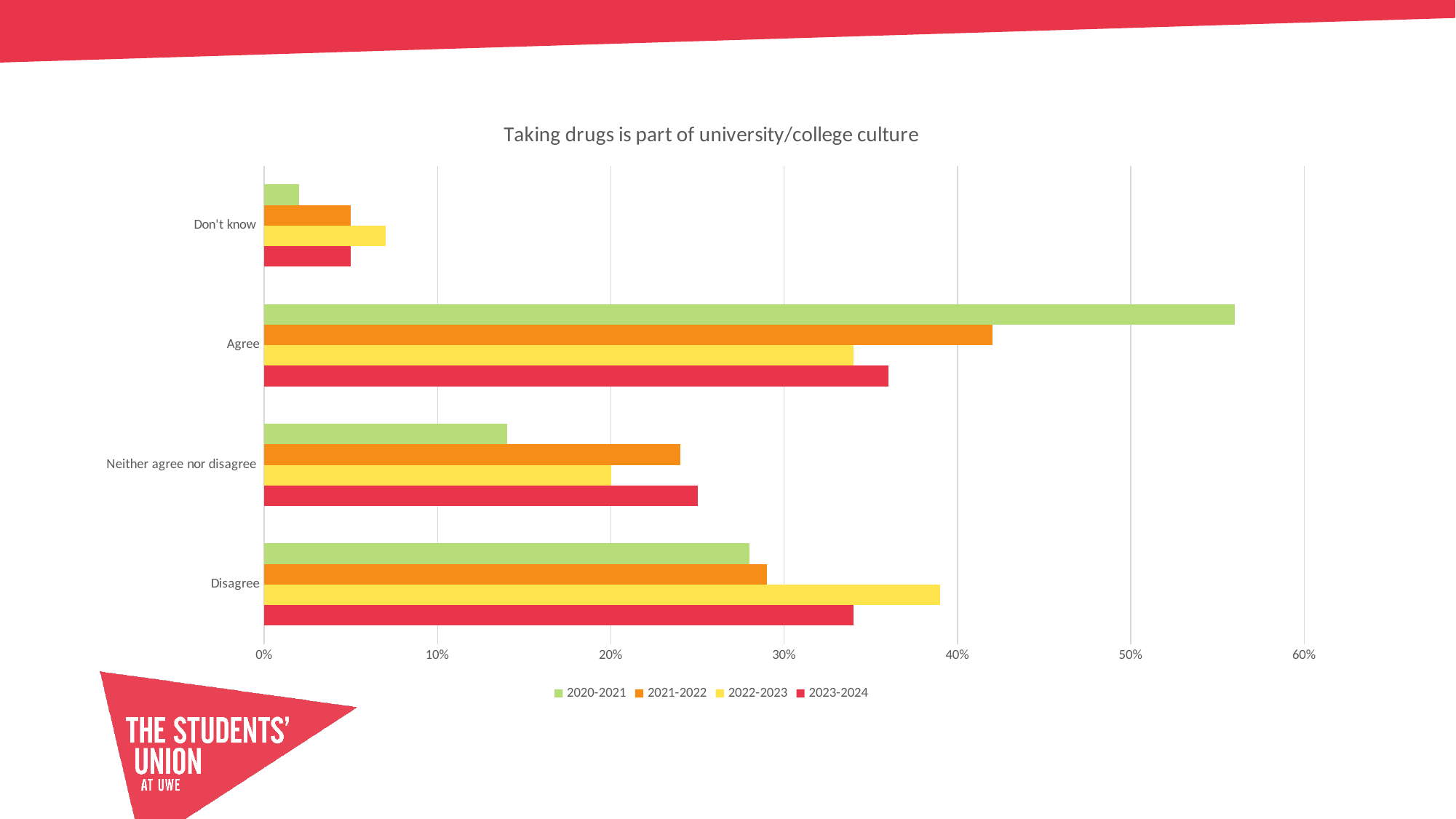
What kind of chart is shown on the slide? bar chart What is the title of the chart? Taking drugs is part of university/college culture Which series is shown in green in the legend? 2020-2021 Is the value for Disagree in 2022-2023 greater or less than 30%? greater Which response category has the longest bar for 2020-2021? Agree For Disagree, which is larger: the 2022-2023 value or the 2023-2024 value? 2022-2023 Which response category has the shortest bar for 2023-2024? Don't know Is the value for Agree in 2020-2021 greater or less than 50%? greater For Agree, which is larger: the 2020-2021 value or the 2021-2022 value? 2020-2021 How many series does the legend list? 4 Is the value for Neither agree nor disagree in 2020-2021 greater or less than 20%? less How many response categories are shown on the vertical axis? 4